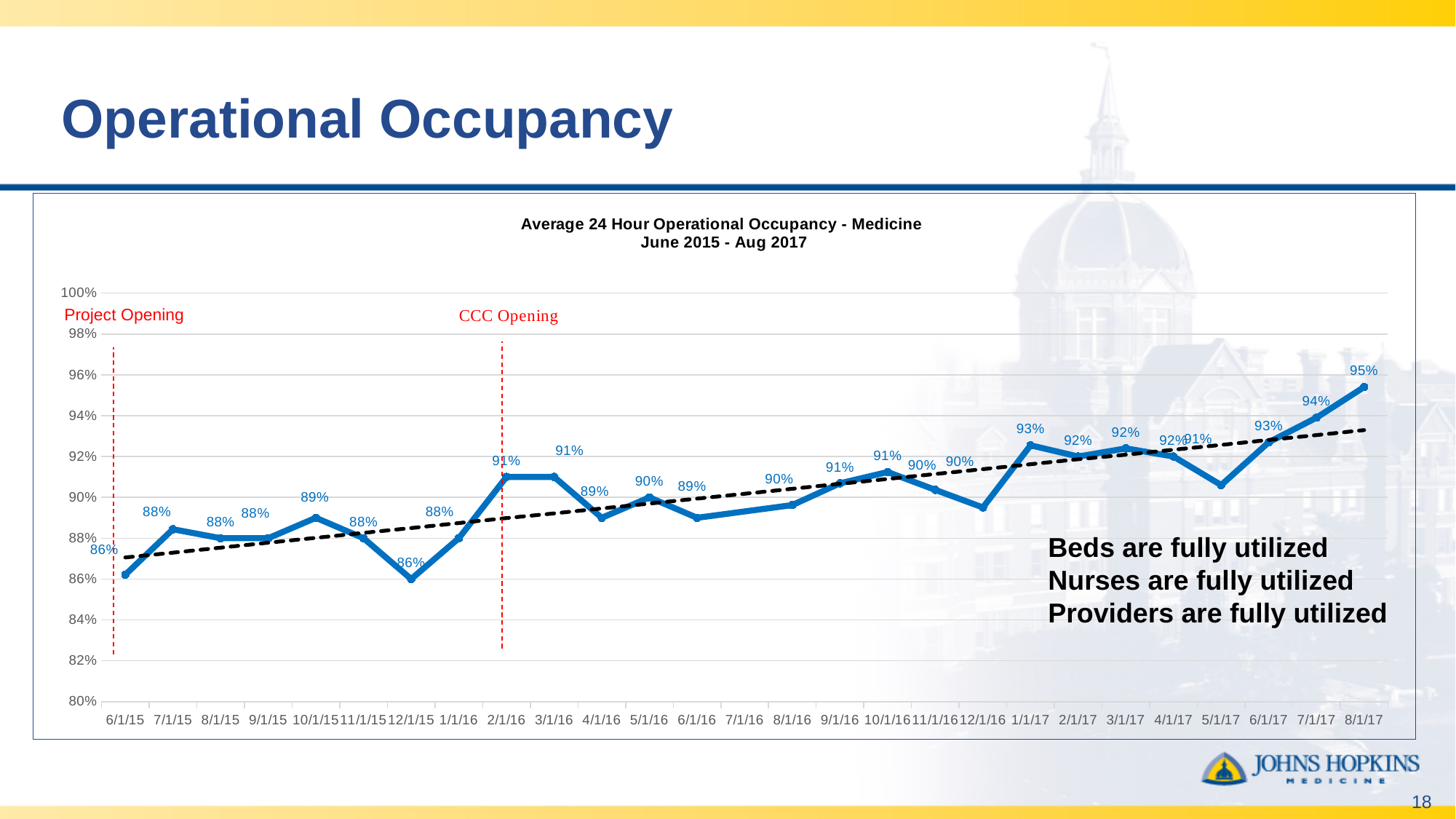
Which is larger, the value for 1/1/17 or the value for 5/1/17? 1/1/17 How many data points are plotted on the x axis? 26 What is the value for 10/1/15? 89% What kind of chart is shown? line chart What is the value for 8/1/17? 95% Do the occupancy values generally rise or fall from June 2015 to August 2017? rise At which date is the 'CCC Opening' marker placed? 2/1/16 What is the value for 7/1/17? 94% Which date has the highest occupancy value? 8/1/17 What is the value for 2/1/16? 91% What is the difference between the value for 8/1/17 and the value for 6/1/15? 9 percentage points